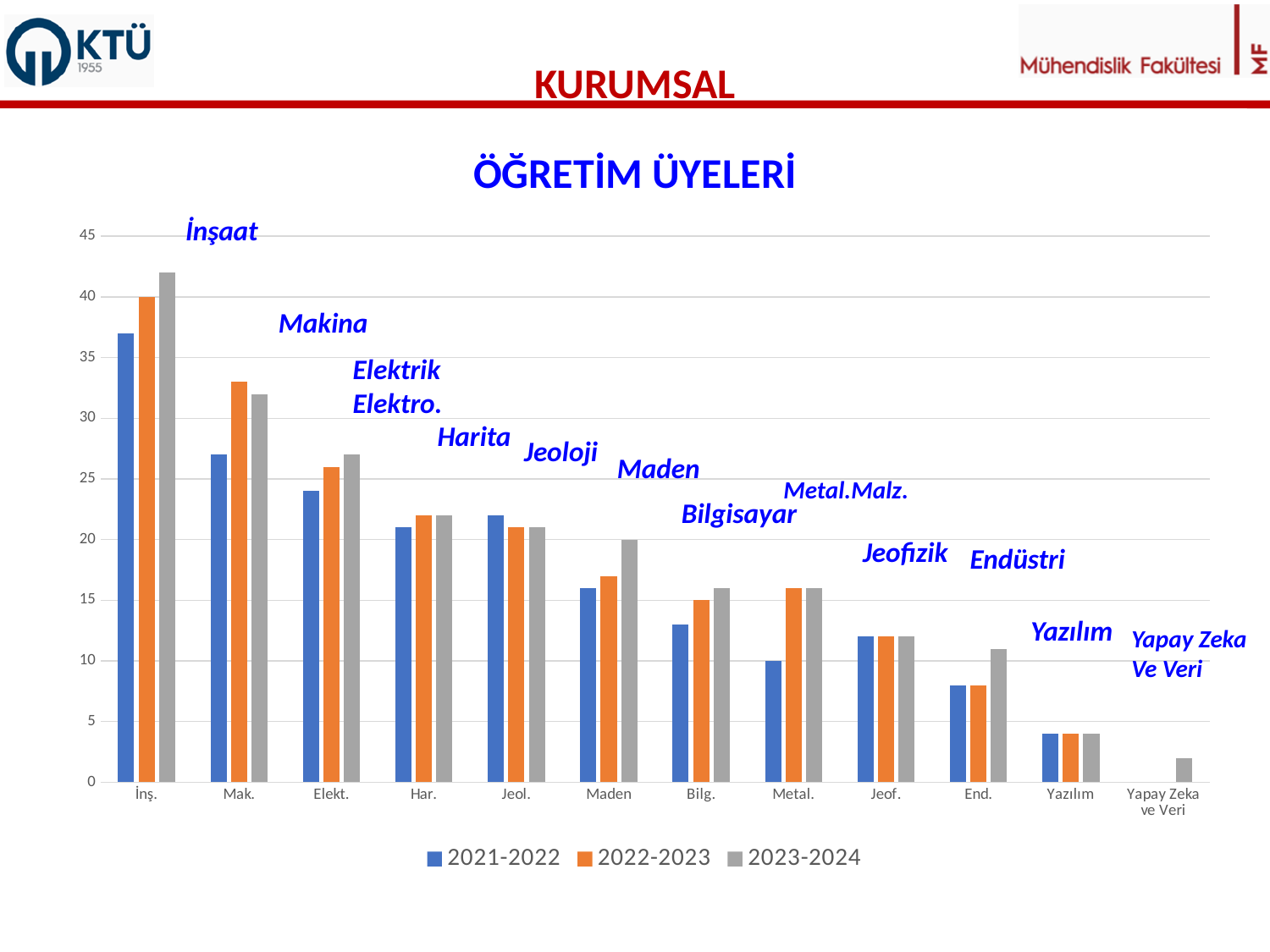
Which department has the lowest 2023-2024 value? Yapay Zeka ve Veri How many departments (categories) are shown on the x axis? 12 Is the 2021-2022 value for Yazılım greater or less than 5? less What are the three series listed in the legend? 2021-2022, 2022-2023, 2023-2024 How many series does the legend list? 3 Which department has the highest 2023-2024 value? İnş. Which is larger, the 2021-2022 value for Elekt. or the 2021-2022 value for Har.? Elekt. What is the 2022-2023 value for İnş.? 40 Is the 2022-2023 value for Mak. greater or less than 30? greater What kind of chart is shown on the slide? bar chart Is the 2021-2022 value for İnş. greater or less than 35? greater Which is larger for Metal., the 2021-2022 value or the 2022-2023 value? 2022-2023